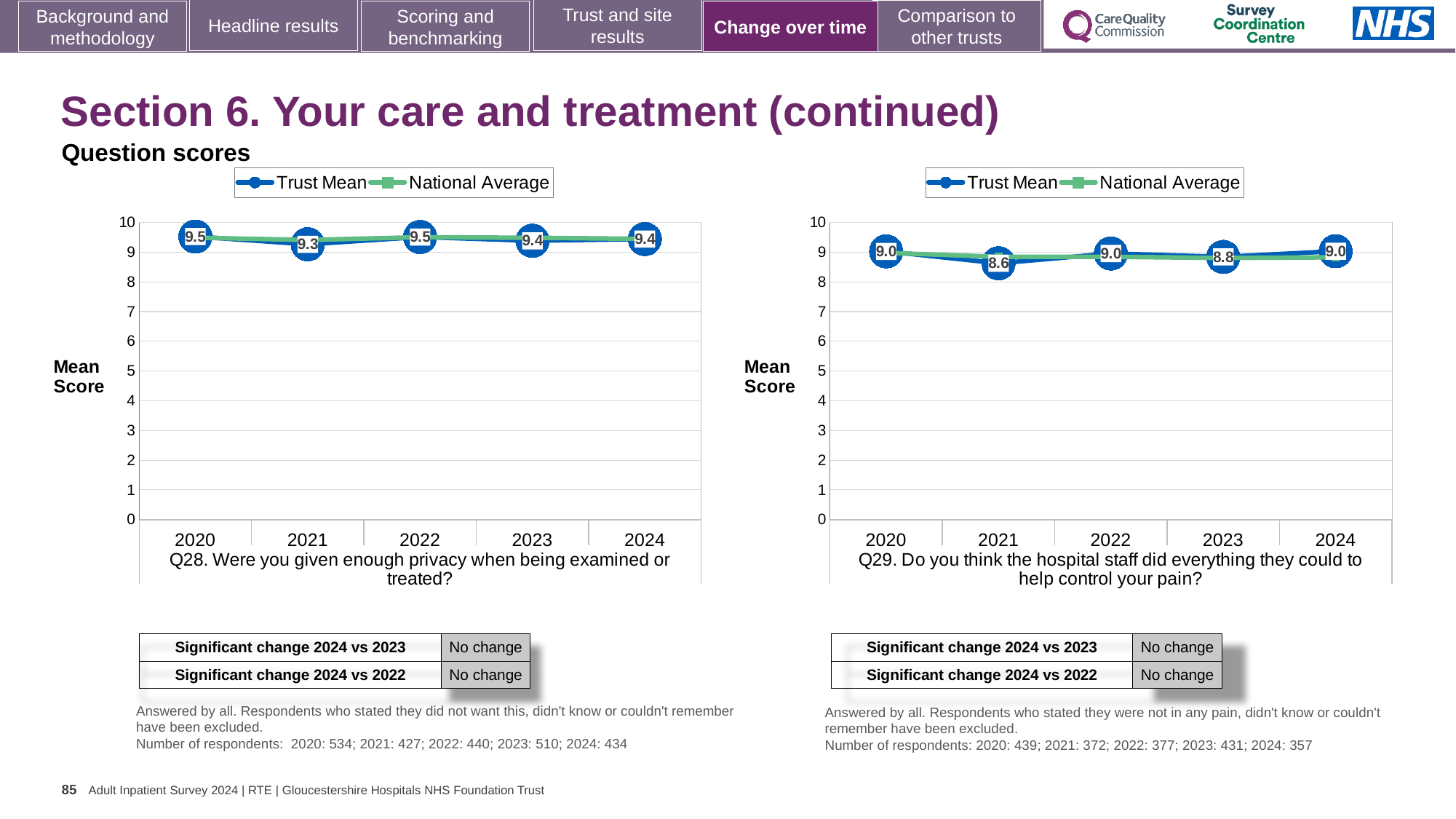
In the Q29 chart (right), what is the difference between the Trust Mean scores for 2024 and 2021? 0.4 In the Q28 chart (left), what is the Trust Mean score for 2024? 9.4 In the Q29 chart (right), which year has the lowest Trust Mean score? 2021 In the Q28 chart (left), which year has the lowest Trust Mean score? 2021 In the Q29 chart (right), is the Trust Mean score for 2022 higher or lower than for 2023? higher How many series does the legend of the Q29 chart (right) list? 2 In the Q29 chart (right), what is the Trust Mean score for 2023? 8.8 In the Q28 chart (left), what is the Trust Mean score for 2020? 9.5 How many years are plotted on the x axis of the Q28 chart (left)? 5 In the Q28 chart (left), what is the Trust Mean score for 2021? 9.3 In the Q29 chart (right), what is the Trust Mean score for 2021? 8.6 In the Q28 chart (left), what is the difference between the Trust Mean scores for 2022 and 2021? 0.2